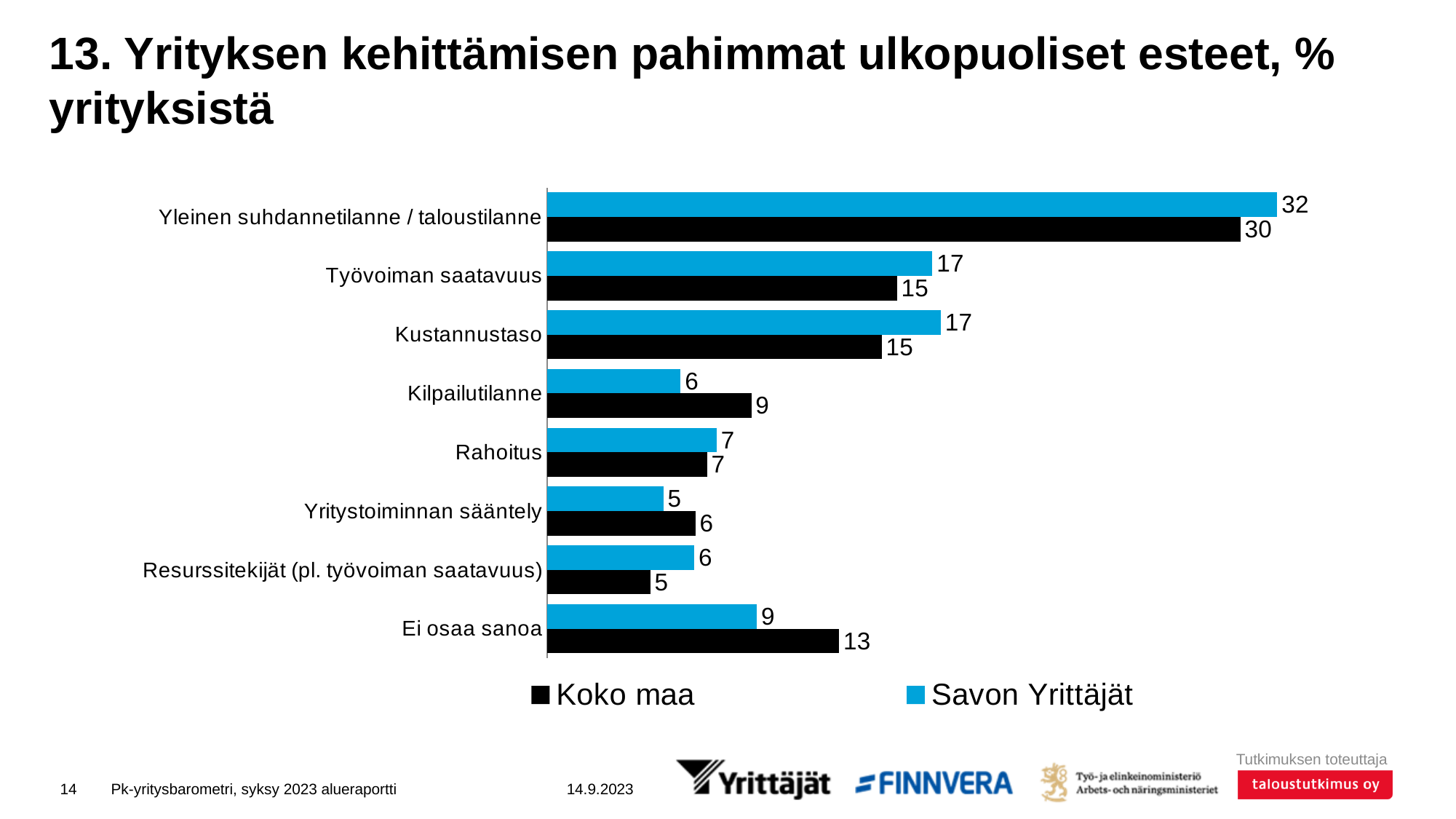
Which category has the lowest value for Savon Yrittäjät? Yritystoiminnan sääntely Which category has the highest value for Koko maa? Yleinen suhdannetilanne / taloustilanne What is the difference between the Savon Yrittäjät and Koko maa values for Yleinen suhdannetilanne / taloustilanne? 2 What is the value for Savon Yrittäjät for Yleinen suhdannetilanne / taloustilanne? 32 What is the difference between the Koko maa and Savon Yrittäjät values for Ei osaa sanoa? 4 What is the value for Koko maa for Ei osaa sanoa? 13 For Työvoiman saatavuus, which series has the larger value, Koko maa or Savon Yrittäjät? Savon Yrittäjät For Kilpailutilanne, which series has the larger value, Koko maa or Savon Yrittäjät? Koko maa How many categories are shown on the chart? 8 How many series does the legend list? 2 What kind of chart is shown on the slide? Bar chart What is the value for Koko maa for Kilpailutilanne? 9